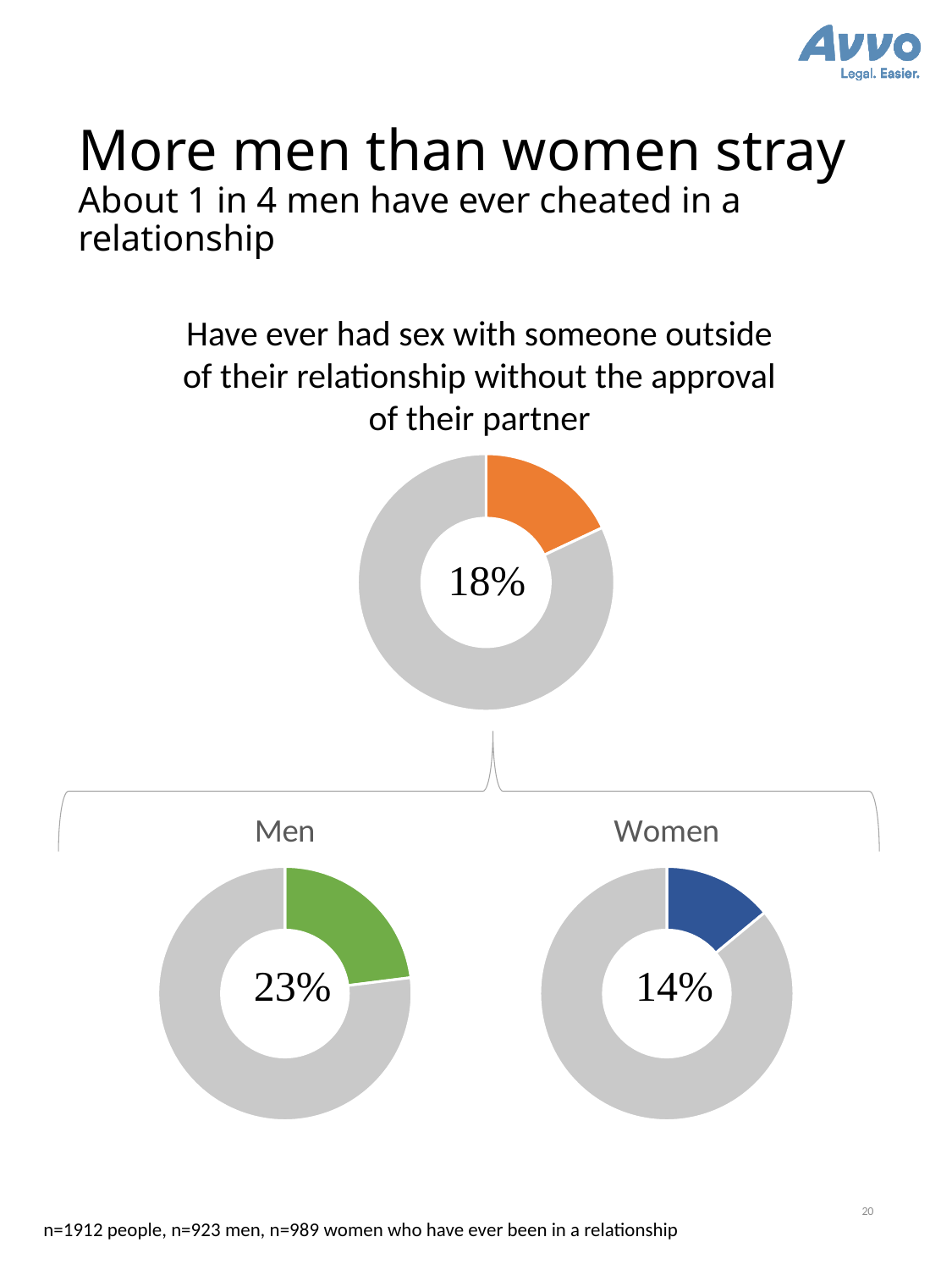
What kind of chart is used for the Men chart? Donut chart How many donut charts are shown on the slide? 3 What is the difference between the percentage in the Men chart and the percentage in the Women chart? 9% What is the difference between the percentage in the top overall chart and the percentage in the Women chart? 4% In the Men chart, what percentage is shown? 23% What colour is the highlighted slice in the Men chart? Green In the Women chart, what percentage is shown? 14% In the Women chart, is the highlighted value greater or less than 20%? less What is the difference between the percentage in the Men chart and the percentage in the top overall chart? 5% What colour is the highlighted slice in the top overall chart? Orange In the top chart titled 'Have ever had sex with someone outside of their relationship without the approval of their partner', what percentage is shown? 18% Comparing the Men and Women charts, which group has the higher percentage? Men